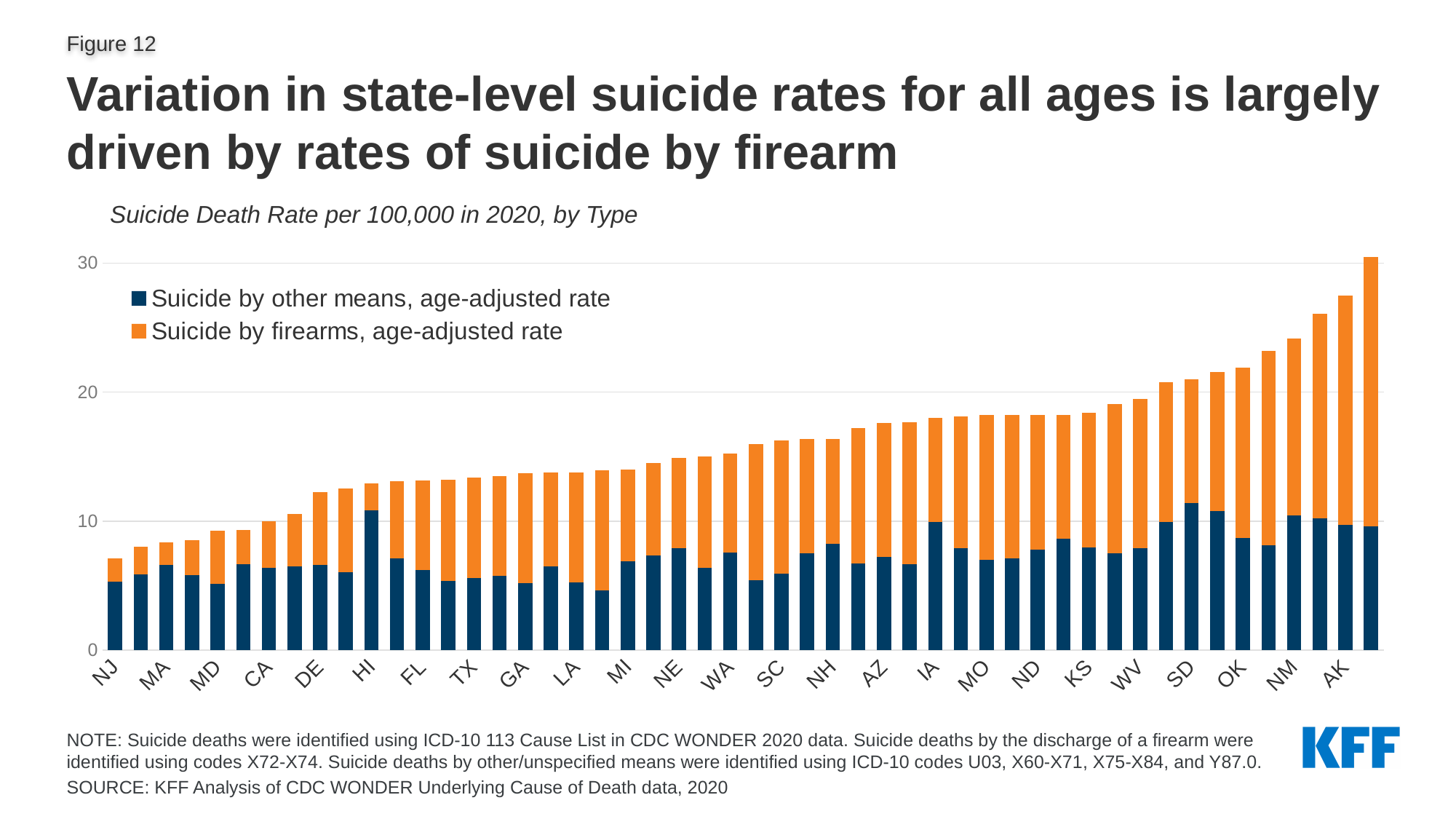
Which state has the larger total suicide death rate, AK or NJ? AK Do the total bar heights rise or fall moving from left to right along the x axis? Rise Which state has the larger rate of suicide by other means, HI or NJ? HI Is the total suicide death rate for NJ greater or less than 10? less Is the total suicide death rate for DE greater or less than 10? greater What kind of chart is shown on the slide? Stacked bar chart How many series does the legend list? 2 What is the subtitle of the chart? Suicide Death Rate per 100,000 in 2020, by Type Which state has the lowest total suicide death rate in the chart? NJ Is the total suicide death rate for NM greater or less than 20? greater Which colour represents 'Suicide by firearms, age-adjusted rate' in the chart? Orange